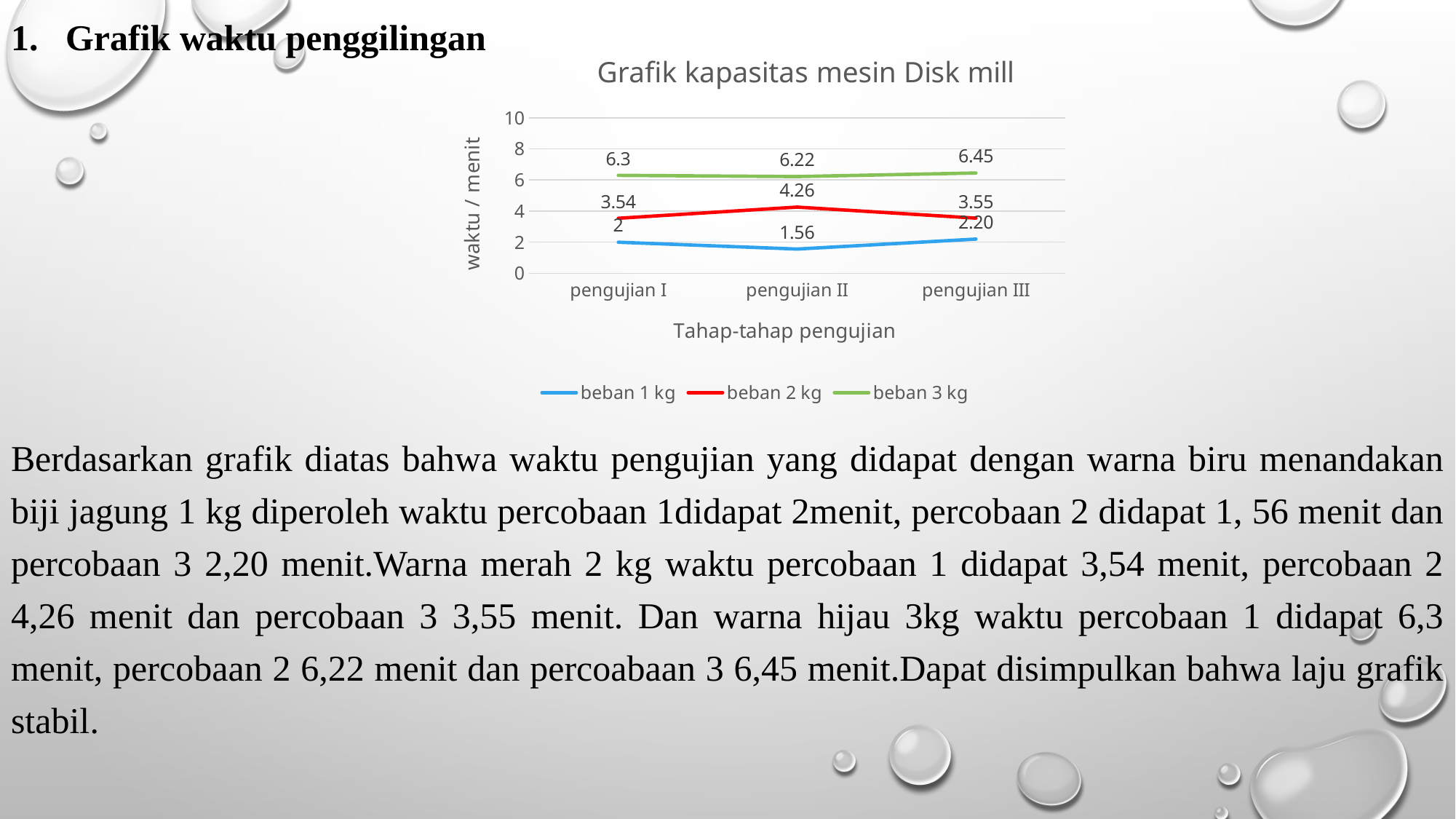
At which pengujian is the value for beban 3 kg the lowest? pengujian II What is the value for beban 1 kg at pengujian II? 1.56 What type of chart is shown on the slide? line chart What is the title of the chart? Grafik kapasitas mesin Disk mill What is the difference between the beban 3 kg and beban 1 kg values at pengujian I? 4.3 What is the value for beban 1 kg at pengujian I? 2 How many categories are shown on the x axis? 3 Which is larger at pengujian III: the value for beban 2 kg or beban 1 kg? beban 2 kg What is the value for beban 3 kg at pengujian III? 6.45 How many series does the legend list? 3 What is the value for beban 2 kg at pengujian II? 4.26 At which pengujian is the value for beban 2 kg the highest? pengujian II